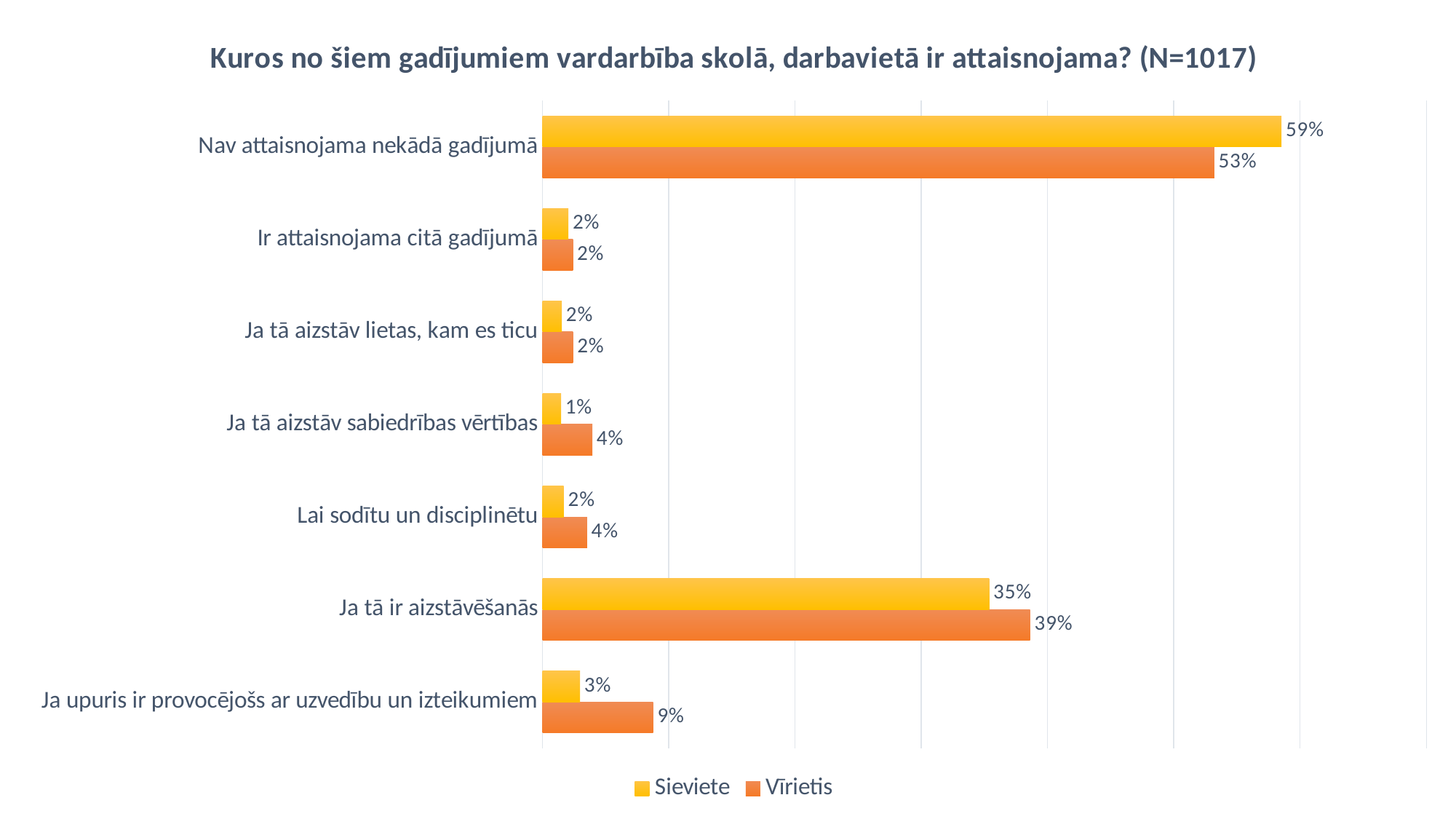
Which category has the lowest value for Sieviete? Ja tā aizstāv sabiedrības vērtības What is the difference between the Vīrietis and Sieviete values for "Ja upuris ir provocējošs ar uzvedību un izteikumiem"? 6% What is the value for Sieviete in the category "Ja tā aizstāv sabiedrības vērtības"? 1% Which category has the highest value for Vīrietis? Nav attaisnojama nekādā gadījumā Which is larger for "Ja tā ir aizstāvēšanās": the Sieviete value or the Vīrietis value? Vīrietis How many categories are shown on the chart? 7 How many series does the legend list? 2 What is the value for Vīrietis in the category "Ja tā ir aizstāvēšanās"? 39% What kind of chart is shown on the slide? Bar chart What is the value for Sieviete in the category "Nav attaisnojama nekādā gadījumā"? 59% What is the difference between the Sieviete and Vīrietis values for "Nav attaisnojama nekādā gadījumā"? 6% What is the value for Vīrietis in the category "Ja upuris ir provocējošs ar uzvedību un izteikumiem"? 9%